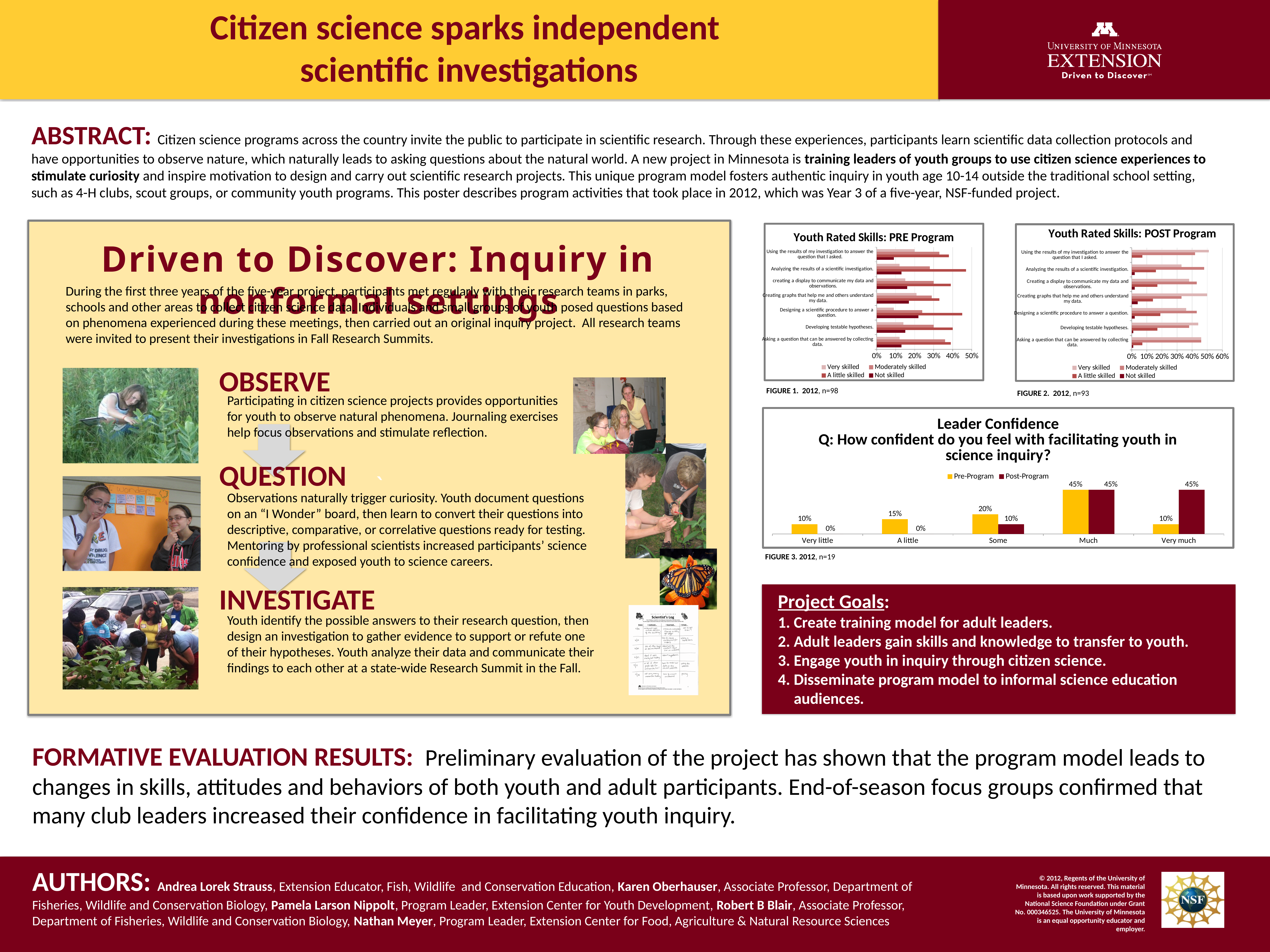
In the Leader Confidence chart, what is the Pre-Program value for "Much"? 45% In the Leader Confidence chart, how many categories are shown on the x axis? 5 What kind of chart is the Leader Confidence chart? Bar chart In the Youth Rated Skills: PRE Program chart, how many series does the legend list? 4 In the Leader Confidence chart, which is larger for "Very much": the Pre-Program or the Post-Program value? Post-Program In the Leader Confidence chart, which category has the highest Pre-Program value? Much In the Youth Rated Skills: POST Program chart, is the "Very skilled" value for "Using the results of my investigation to answer the question that I asked" greater or less than 40%? greater In the Leader Confidence chart, how many series does the legend list? 2 In the Youth Rated Skills: POST Program chart, how many skill categories are listed on the vertical axis? 7 In the Leader Confidence chart, what is the difference between the Pre-Program and Post-Program values for "Some"? 10% In the Leader Confidence chart, what is the Post-Program value for "Very little"? 0% In the Leader Confidence chart, what is the Post-Program value for "Very much"? 45%